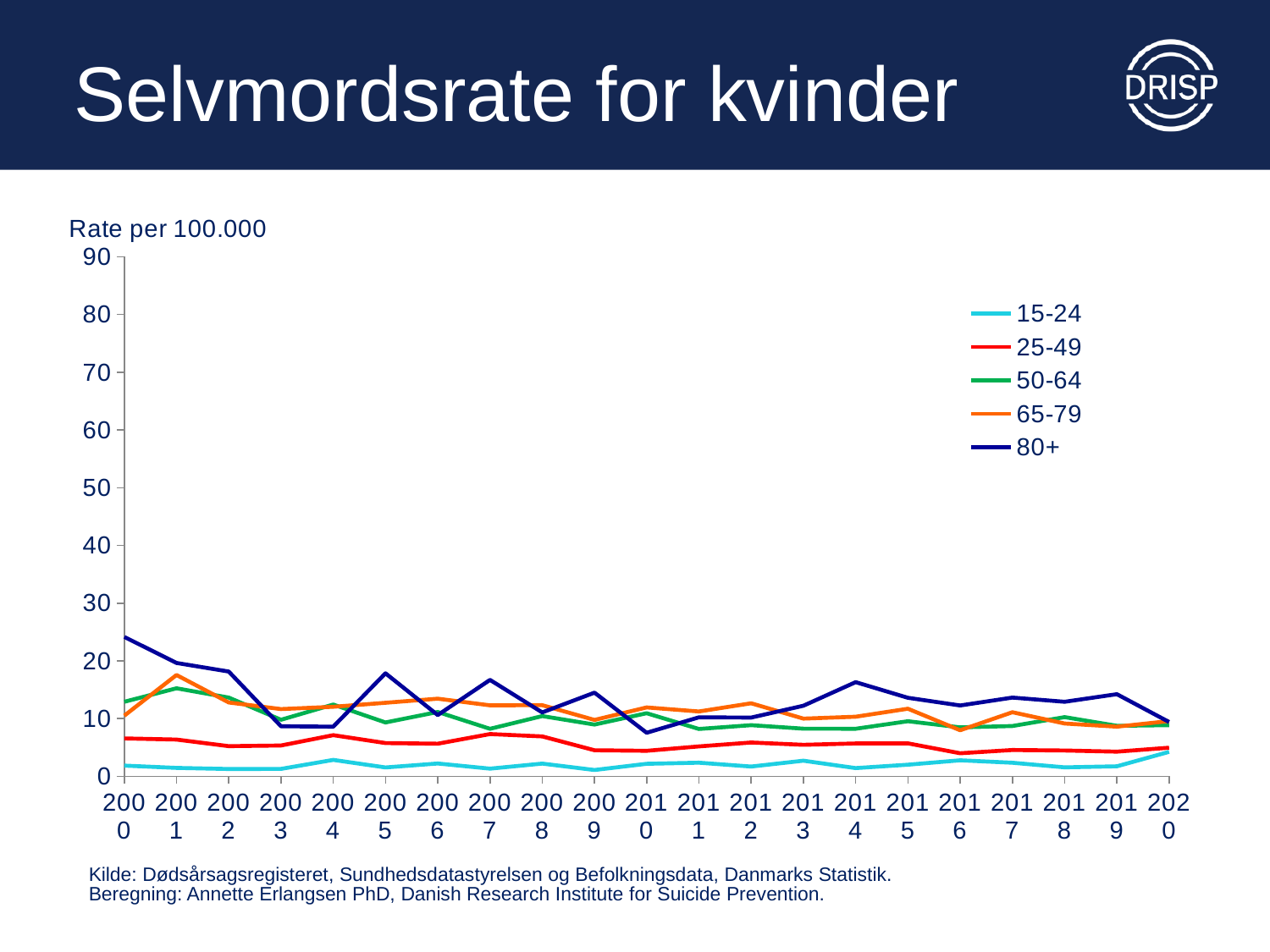
What label is shown above the y axis? Rate per 100.000 How many series does the legend list? 5 Which series has the lowest value in 2000? 15-24 What is the title of the slide? Selvmordsrate for kvinder In 2014, which is larger: the value for 80+ or the value for 25-49? 80+ Which series has the highest value in 2000? 80+ Is the value for the 65-79 series in 2001 greater or less than 15? greater Does the 80+ series rise or fall from 2000 to 2003? fall What kind of chart is shown on the slide? line chart Is the value for the 15-24 series in 2000 greater or less than 10? less How many years are shown along the x axis? 21 Is the value for the 80+ series in 2000 greater or less than 20? greater